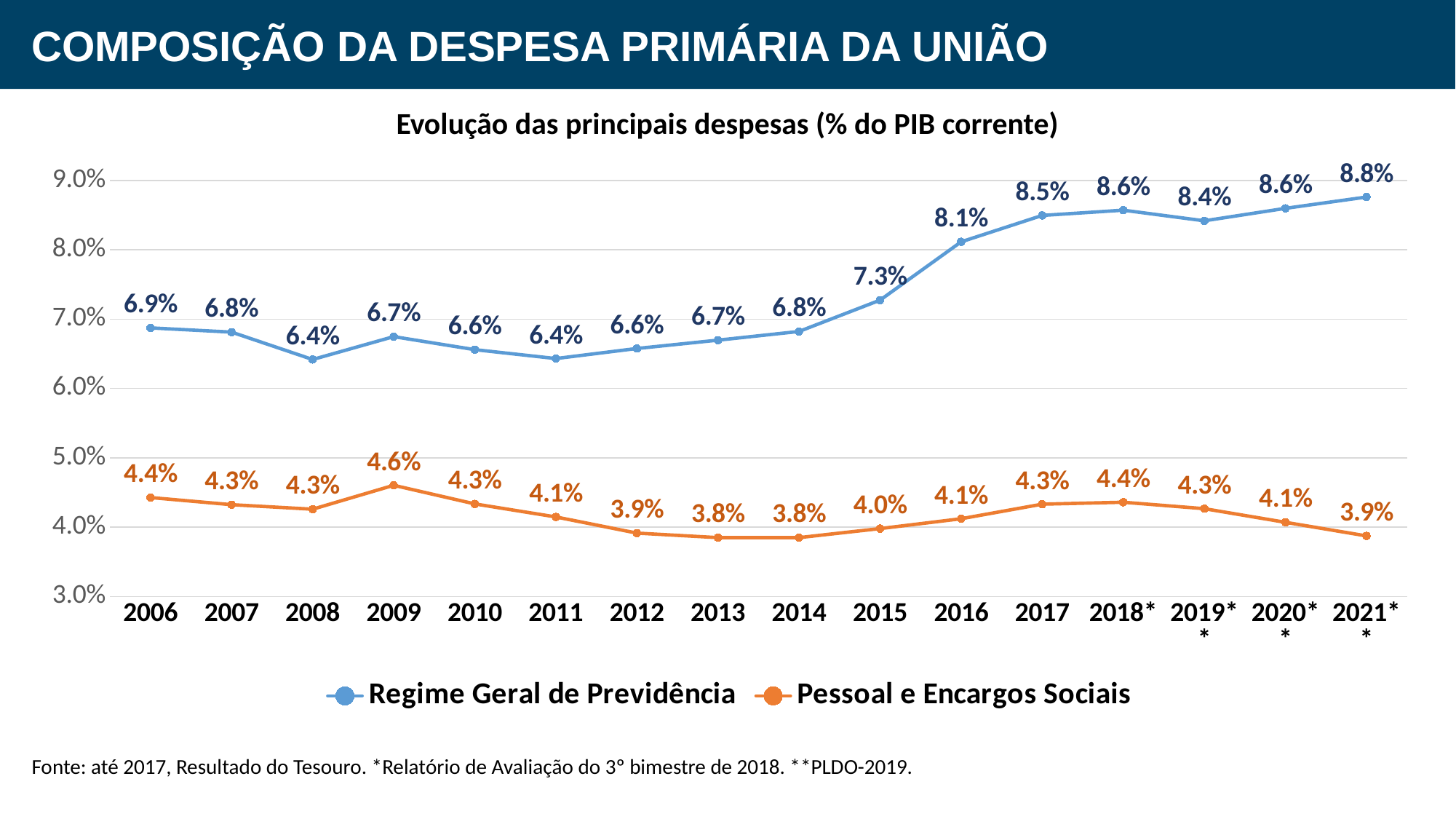
What is the value for Pessoal e Encargos Sociais in 2009? 4.6% What is the difference between Regime Geral de Previdência and Pessoal e Encargos Sociais in 2021**? 4.9 percentage points By how much did Regime Geral de Previdência increase from 2015 to 2016? 0.8 percentage points Which series has the higher value in 2006, Regime Geral de Previdência or Pessoal e Encargos Sociais? Regime Geral de Previdência In which year does Pessoal e Encargos Sociais reach its highest value? 2009 What is the value for Regime Geral de Previdência in 2016? 8.1% What is the value for Pessoal e Encargos Sociais in 2021**? 3.9% How many years are shown on the x axis? 16 How many series does the legend list? 2 In which year does Regime Geral de Previdência reach its highest value? 2021** What kind of chart is shown on the slide? Line chart Does Regime Geral de Previdência rise or fall from 2014 to 2017? Rise